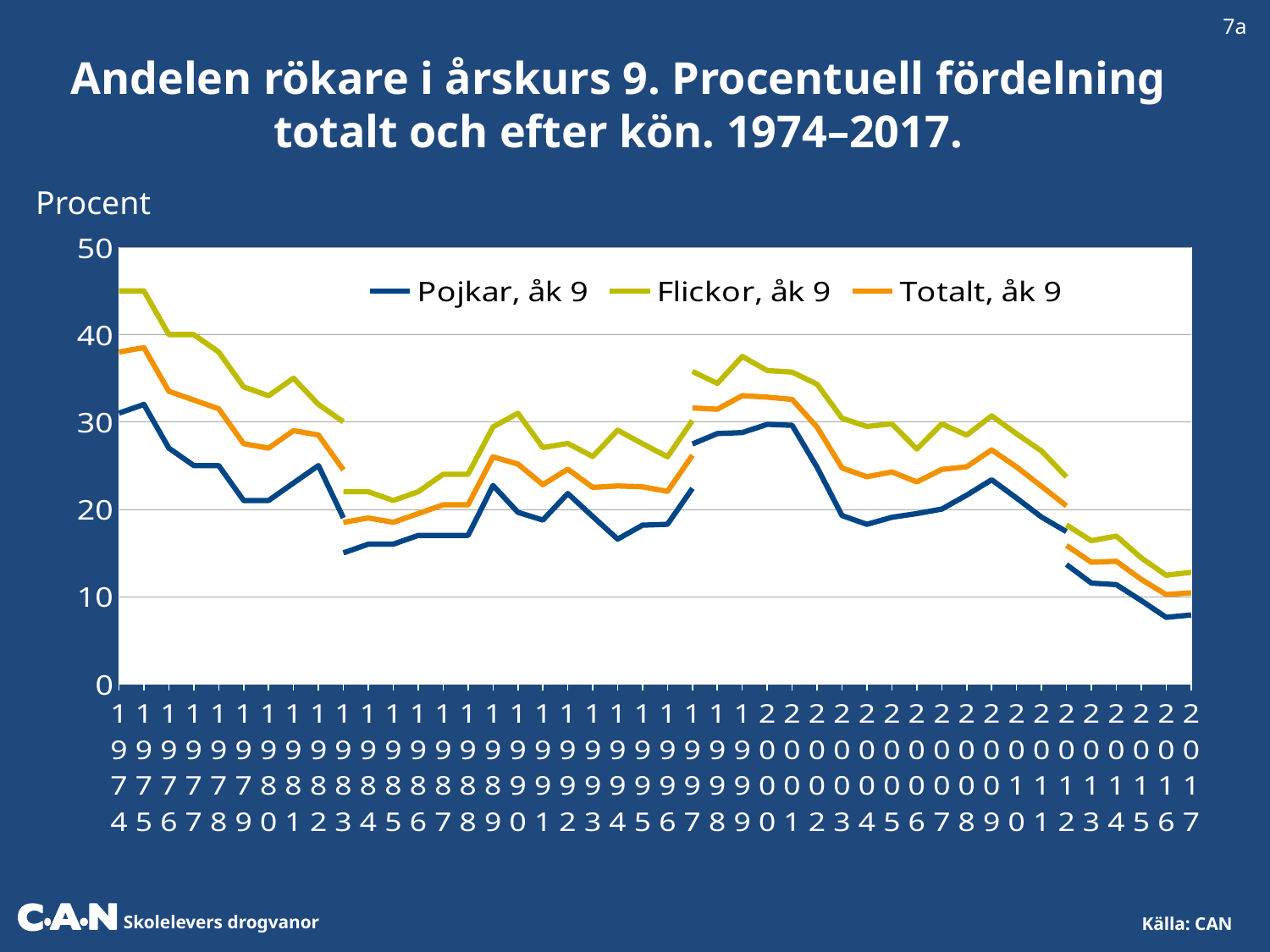
What is the title of the chart? Andelen rökare i årskurs 9. Procentuell fördelning totalt och efter kön. 1974–2017. What is the last year shown on the x axis? 2017 What kind of chart is shown on the slide? Line chart Is the value for Flickor, åk 9 in 1974 greater or less than 40? greater What is the first year shown on the x axis? 1974 How many series does the legend list? 3 In 1974, which series has the higher value, Pojkar, åk 9 or Flickor, åk 9? Flickor, åk 9 What label is shown on the vertical axis? Procent Is the value for Pojkar, åk 9 in 2017 greater or less than 10? less Overall, do the values for Pojkar, åk 9 rise or fall from 1974 to 2017? Fall Is the value for Totalt, åk 9 in 1974 greater or less than 30? greater